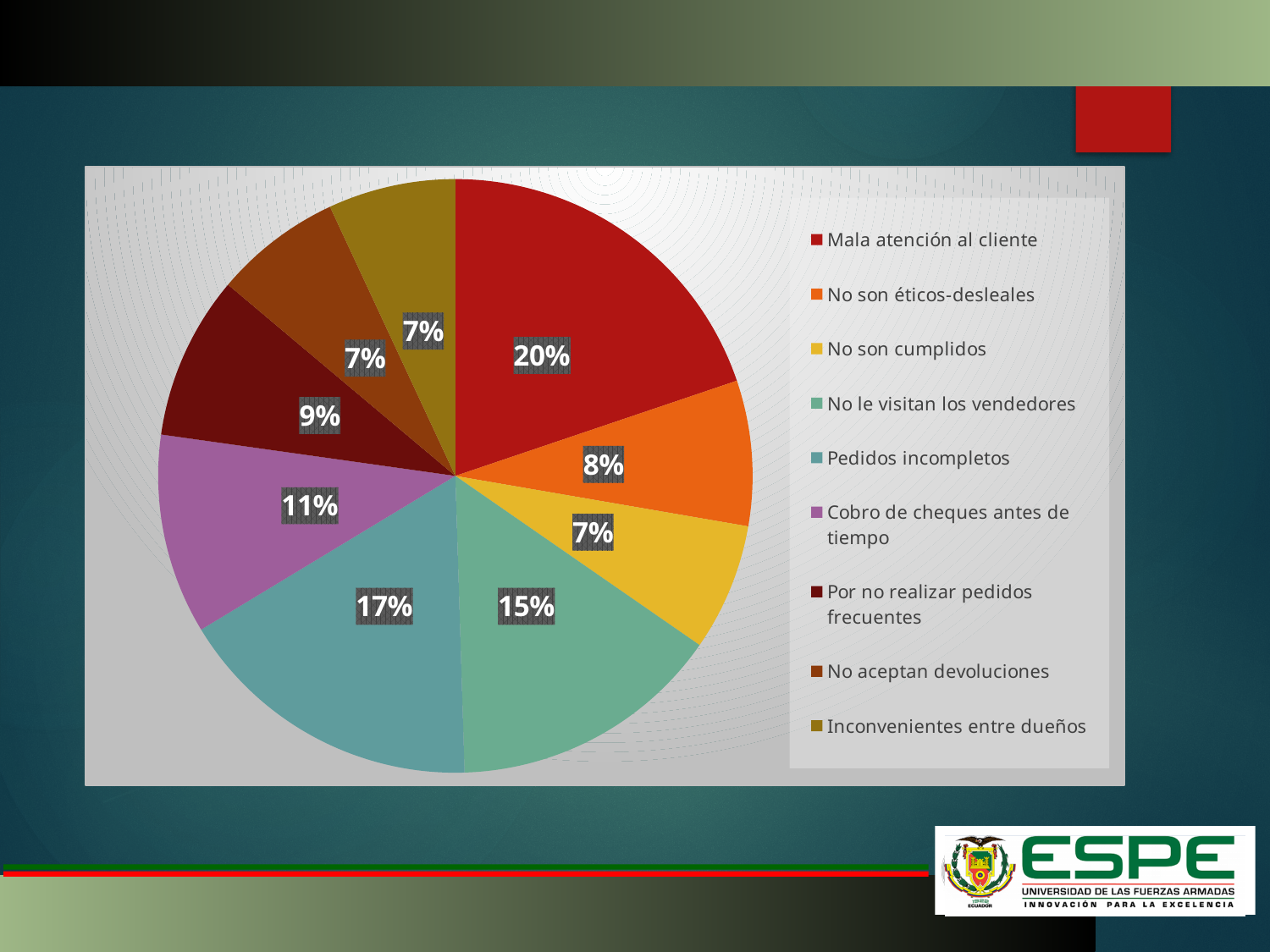
What share of the pie does "No le visitan los vendedores" represent? 15% What share of the pie does "Cobro de cheques antes de tiempo" represent? 11% What colour is the slice for "Cobro de cheques antes de tiempo"? purple Which is larger, the share for "No le visitan los vendedores" or the share for "Cobro de cheques antes de tiempo"? No le visitan los vendedores What share of the pie does "Por no realizar pedidos frecuentes" represent? 9% Which category has the largest slice of the pie? Mala atención al cliente How many categories does the pie chart have? 9 What is the difference between the shares of "Mala atención al cliente" and "Pedidos incompletos"? 3% What kind of chart is shown on the slide? pie chart